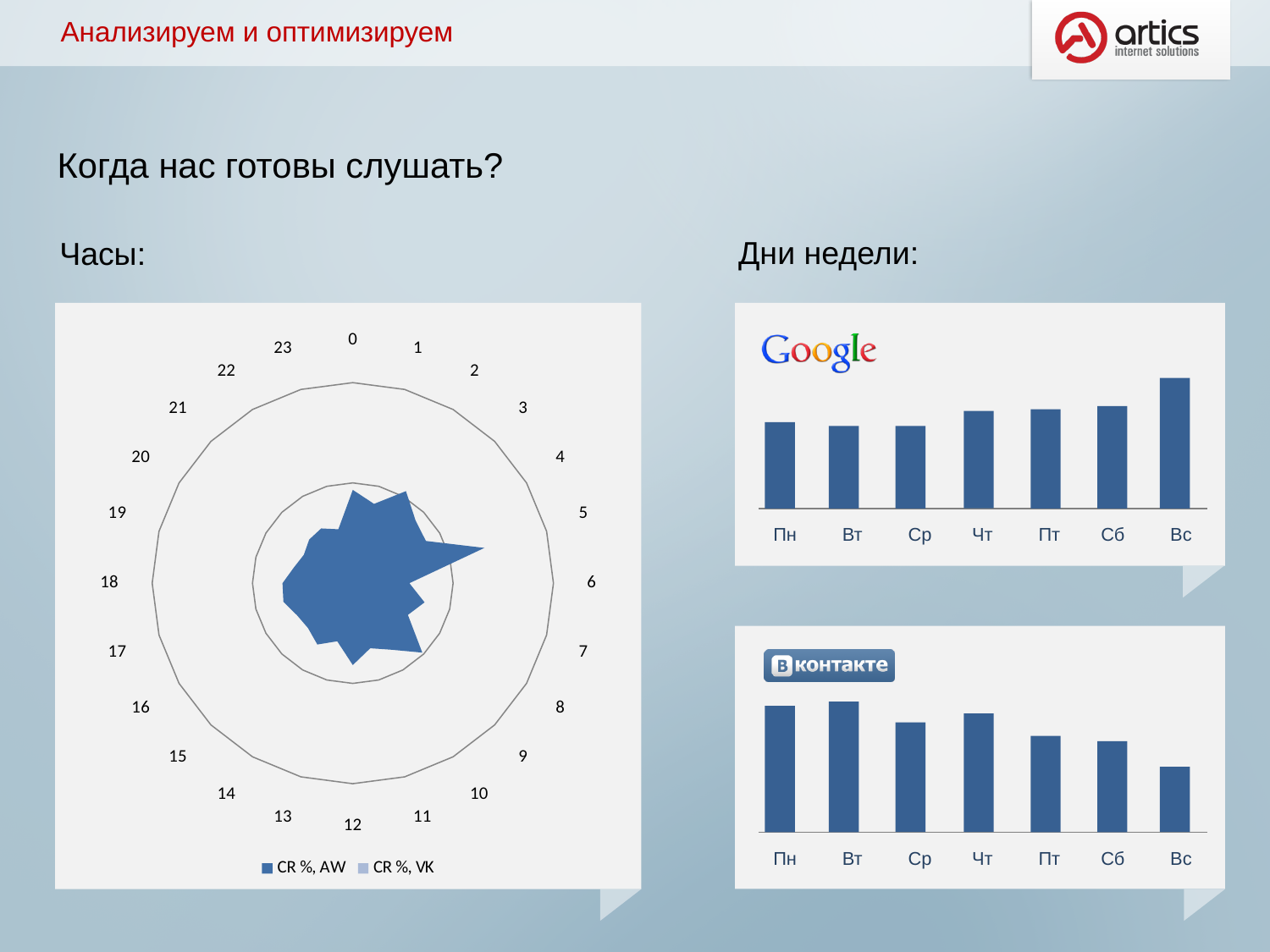
What kind of chart is the "Часы" chart on the left of the slide? radar chart In the Google bar chart, which day has the highest bar? Вс What kind of chart is the Google chart under "Дни недели"? bar chart How many hour categories are plotted around the "Часы" radar chart? 24 In the Google bar chart, is the bar for Вс taller or shorter than the bar for Пн? taller In the ВКонтакте bar chart, do the bars generally rise or fall from Пн to Вс? fall In the ВКонтакте bar chart, which day has the highest bar? Вт What are the two legend entries of the "Часы" radar chart? CR %, AW and CR %, VK In the ВКонтакте bar chart, which day has the lowest bar? Вс In the "Часы" radar chart, at which hour does the plotted area reach farthest from the centre? 5 How many days are plotted in the Google bar chart? 7 How many series does the legend of the "Часы" radar chart list? 2